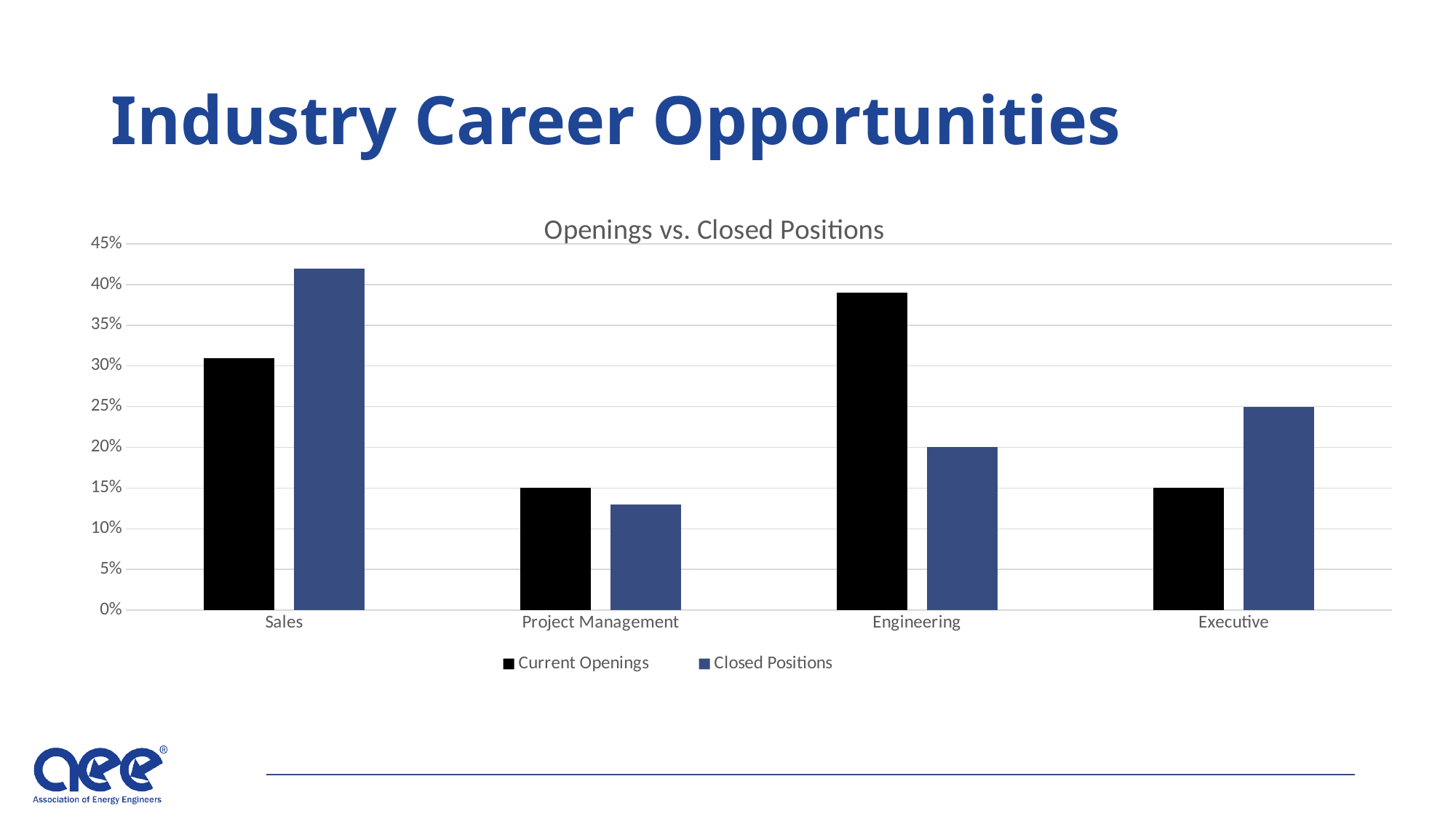
How many series does the legend list? 2 Which category has the highest Current Openings value? Engineering What kind of chart is shown on the slide? bar chart Is the Closed Positions value for Sales greater or less than 40%? greater What is the title of the chart? Openings vs. Closed Positions Is the Current Openings value for Sales greater or less than 35%? less What is the Closed Positions value for Engineering? 20% What is the Closed Positions value for Executive? 25% What is the Current Openings value for Project Management? 15% How many categories are shown on the x axis? 4 For Executive, which is larger: Current Openings or Closed Positions? Closed Positions Which category has the lowest Closed Positions value? Project Management